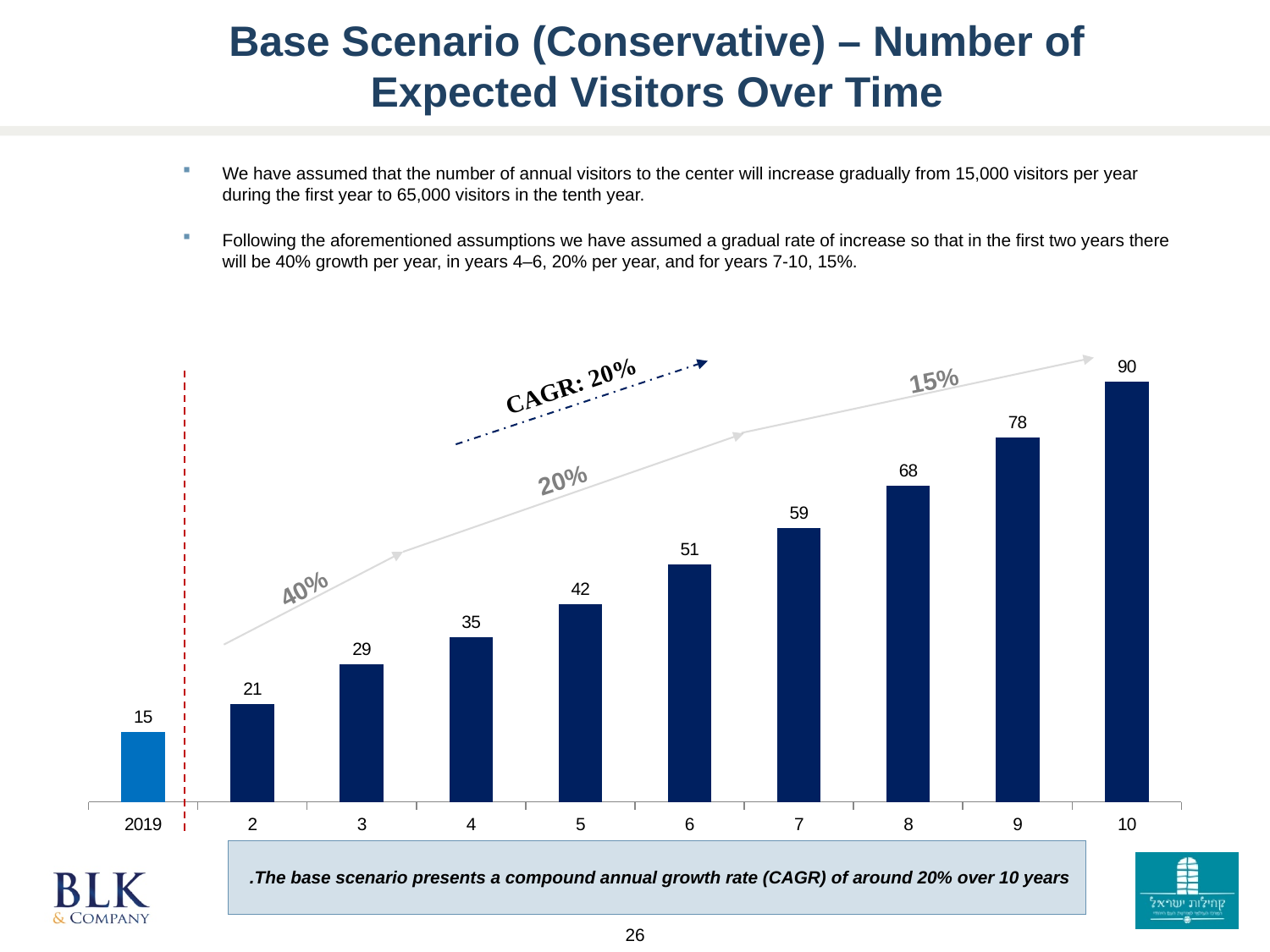
Which is larger, the value for year 4 or the value for year 9? 9 Which year has the highest value? 10 What is the difference between the values for year 7 and year 6? 8 What kind of chart is shown on the slide? bar chart What growth rate label is shown above the bars for years 7 to 10? 15% What is the value shown for year 8? 68 What is the difference between the values for year 10 and year 2019? 75 Which year has the lowest value? 2019 What is the value shown for year 5? 42 What is the value shown for year 2019? 15 How many bars are plotted in the chart? 10 Do the values rise or fall from left to right along the x axis? rise